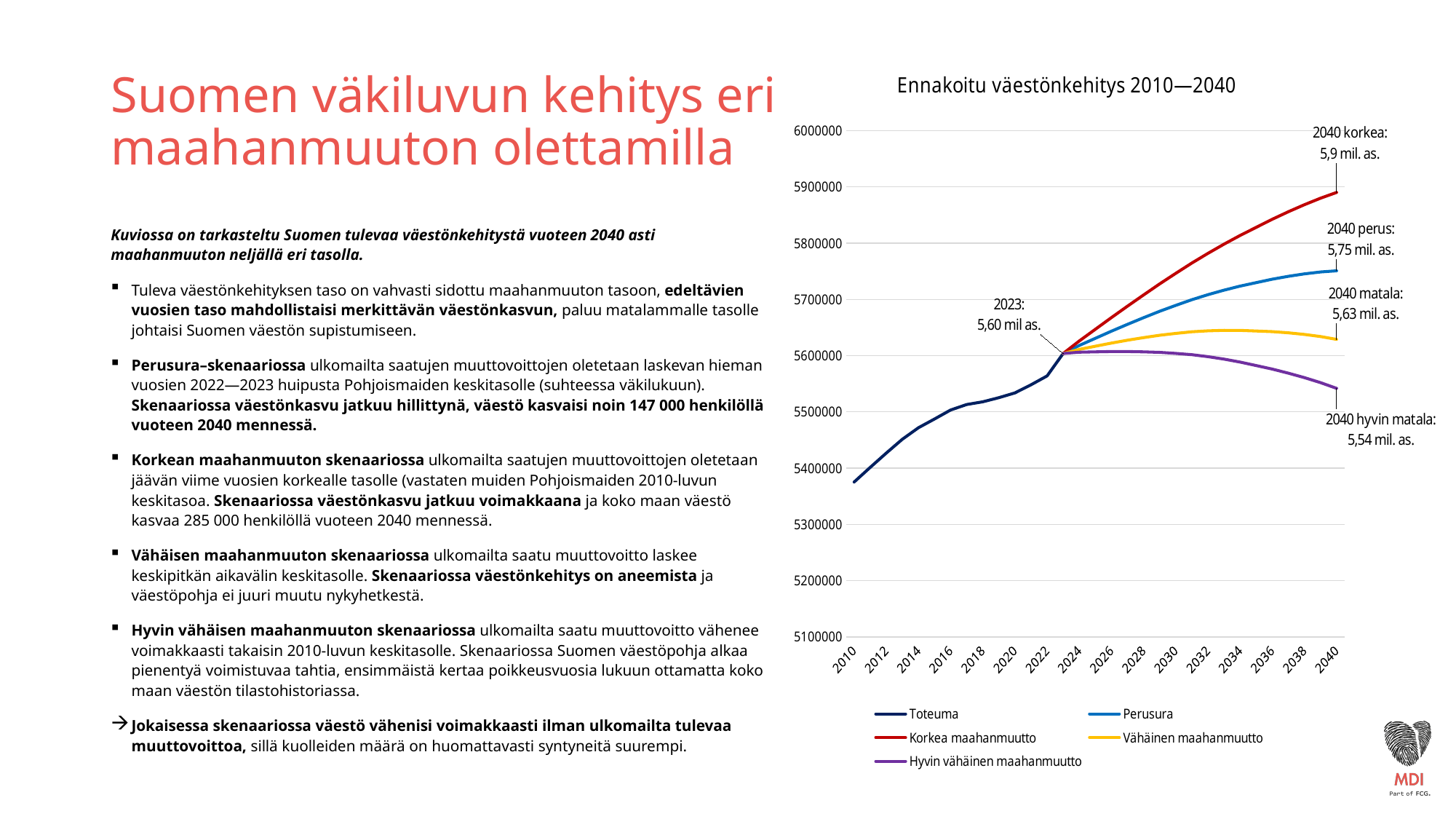
According to the annotation, what is the population value for 2023? 5,60 mil as. What is the difference between the annotated 2040 values of the 'perus' and 'matala' scenarios? 0,12 mil. as. What is the annotated 2040 value for the 'perus' (Perusura) scenario? 5,75 mil. as. Which scenario has the highest population value in 2040? Korkea maahanmuutto What kind of chart is shown on the slide? line chart What is the title of the chart? Ennakoitu väestönkehitys 2010—2040 What is the annotated 2040 value for the 'korkea' (Korkea maahanmuutto) scenario? 5,9 mil. as. Is the Toteuma value for 2010 greater or less than 5400000? less Does the Hyvin vähäinen maahanmuutto line rise or fall between 2030 and 2040? fall Which scenario has the lowest population value in 2040? Hyvin vähäinen maahanmuutto What is the annotated 2040 value for the 'hyvin matala' scenario? 5,54 mil. as. How many series does the chart legend list? 5